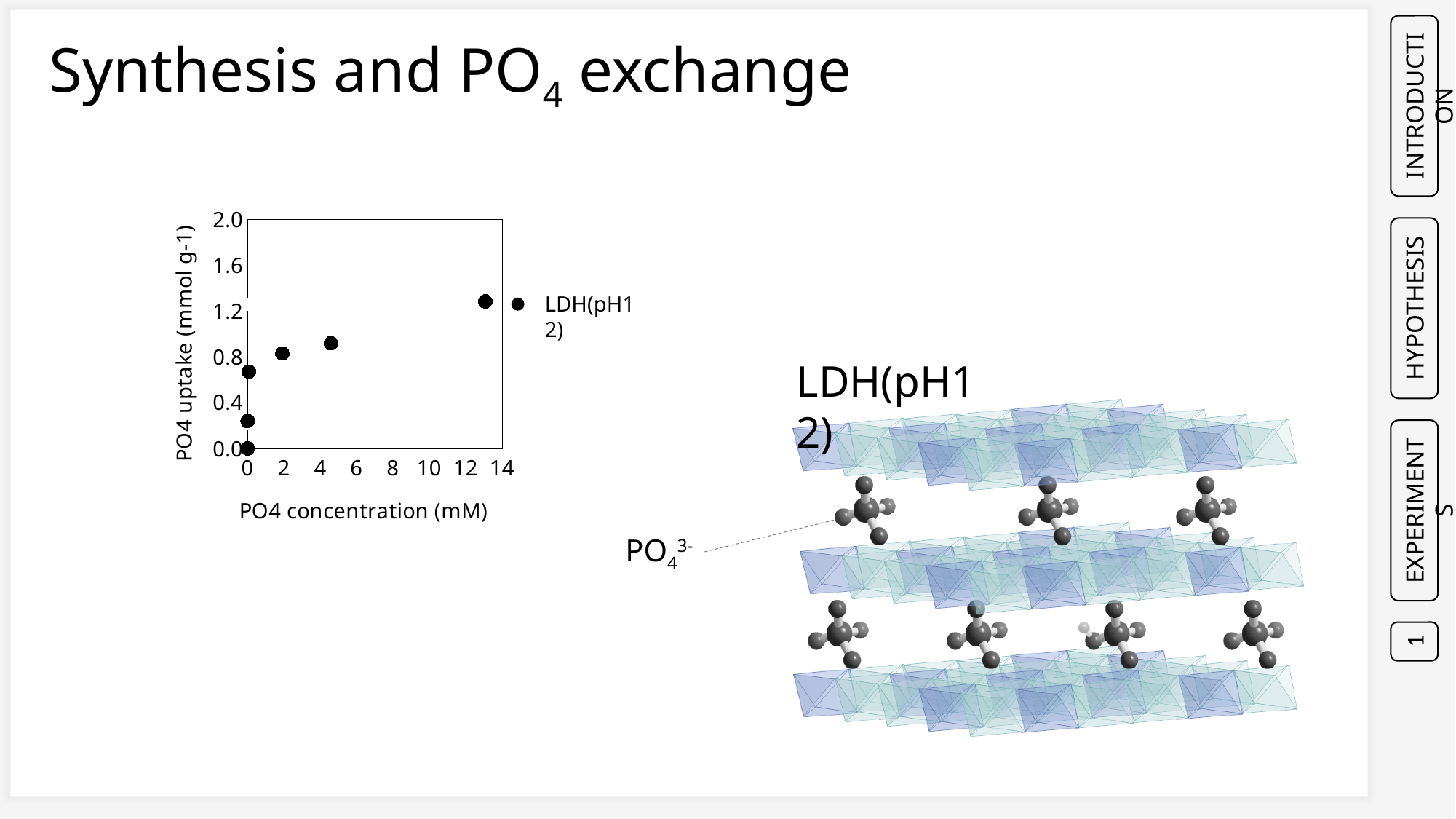
Is the PO4 uptake value for the point at about 4.5 mM greater or less than 0.8? greater What is the name of the series shown in the chart's legend? LDH(pH12) What kind of chart is shown on the slide? scatter chart Is the PO4 uptake value for the point at about 2 mM greater or less than 1.2? less How many data points are plotted in the chart? 6 Which point has the highest PO4 uptake: the one at about 2 mM or the one at about 13 mM? the one at about 13 mM Is the highest PO4 uptake value in the chart greater or less than 1.6? less What is the title of the chart's x axis? PO4 concentration (mM) Does PO4 uptake rise or fall as PO4 concentration increases along the x axis? rise How many series does the chart's legend list? 1